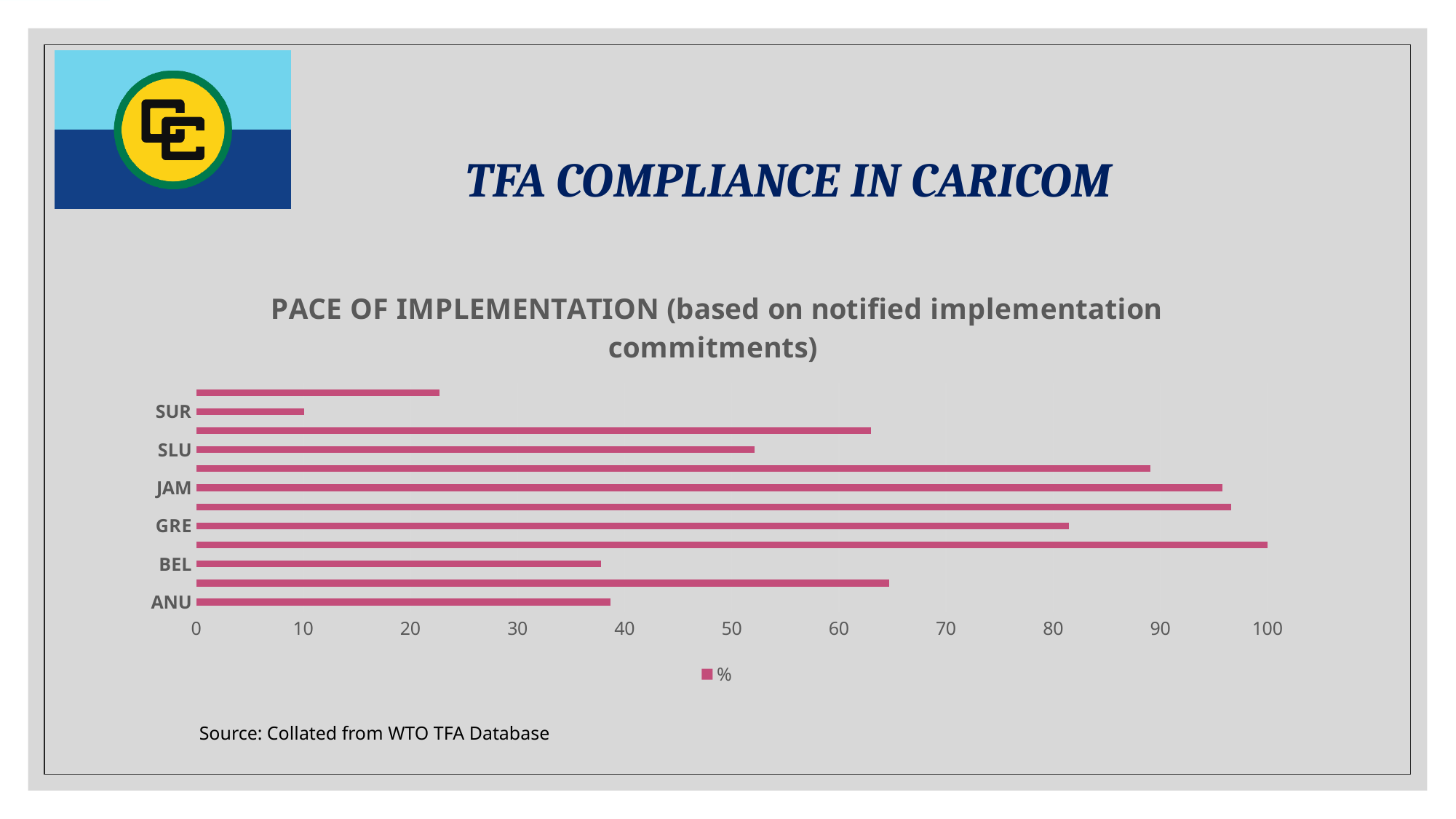
What kind of chart is shown on the slide? Bar chart Is the value for SLU greater or less than 40? greater How many bars are plotted in the chart? 12 What is the title of the chart? PACE OF IMPLEMENTATION (based on notified implementation commitments) Is the value for SUR greater or less than 20? less Which has the larger value, JAM or GRE? JAM Is the value for ANU greater or less than 50? less Which of the labelled categories has the lowest value? SUR How many series does the chart legend list? 1 What is the legend entry for the series in the chart? %